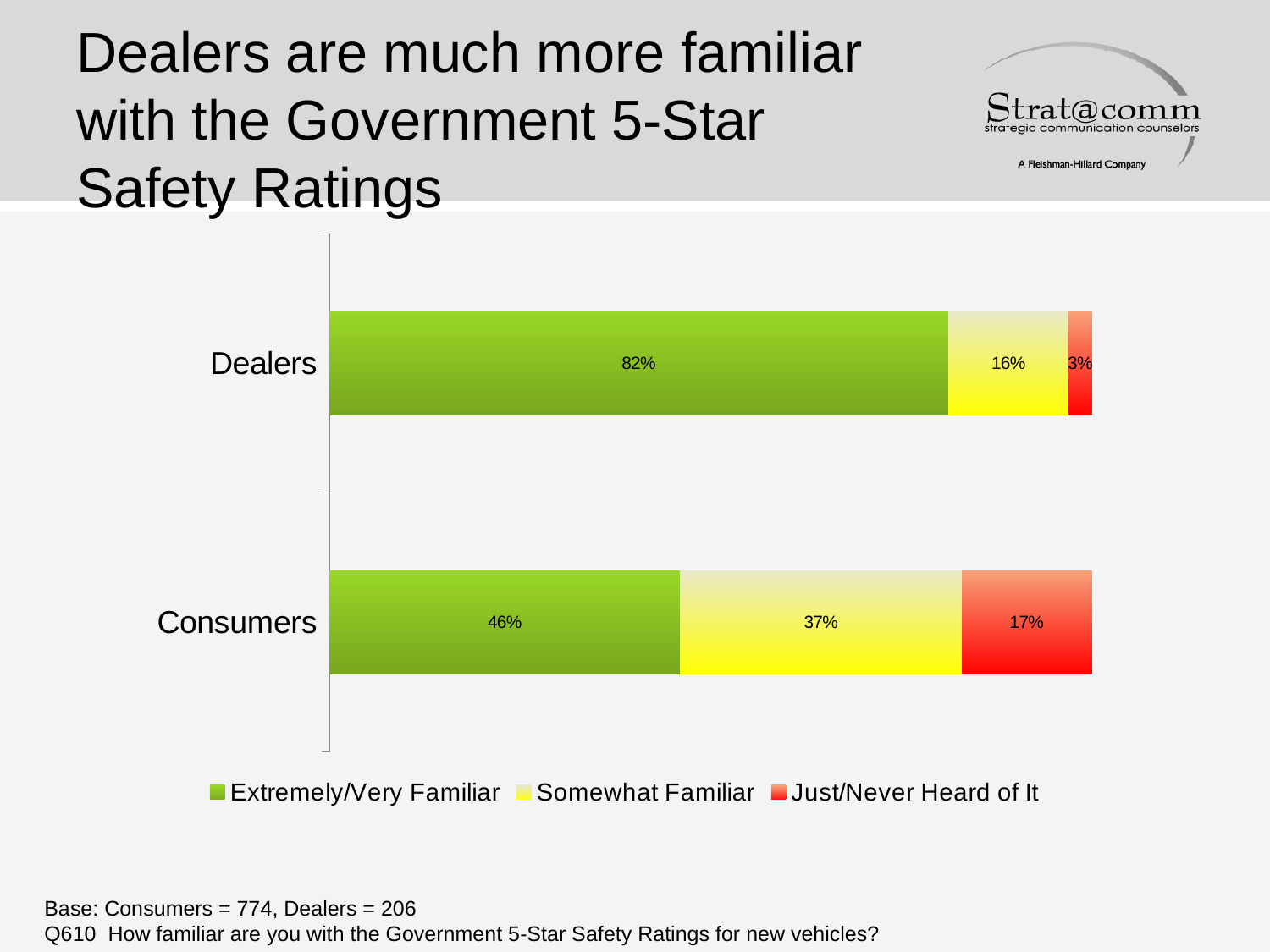
What is the difference in percentage points between Dealers and Consumers for Extremely/Very Familiar? 36 What percentage of Dealers are Extremely/Very Familiar with the Government 5-Star Safety Ratings? 82% What colour represents the Just/Never Heard of It series? Red What is the difference in percentage points between Consumers and Dealers for Just/Never Heard of It? 14 Which group has the higher share of Extremely/Very Familiar respondents, Dealers or Consumers? Dealers What percentage of Consumers are Somewhat Familiar? 37% What type of chart is shown on the slide? Stacked bar chart What percentage of Consumers have Just/Never Heard of It? 17% How many groups (categories) are shown on the chart? 2 Which group has the lowest Just/Never Heard of It percentage? Dealers How many series does the legend list? 3 What percentage of Dealers are Somewhat Familiar? 16%